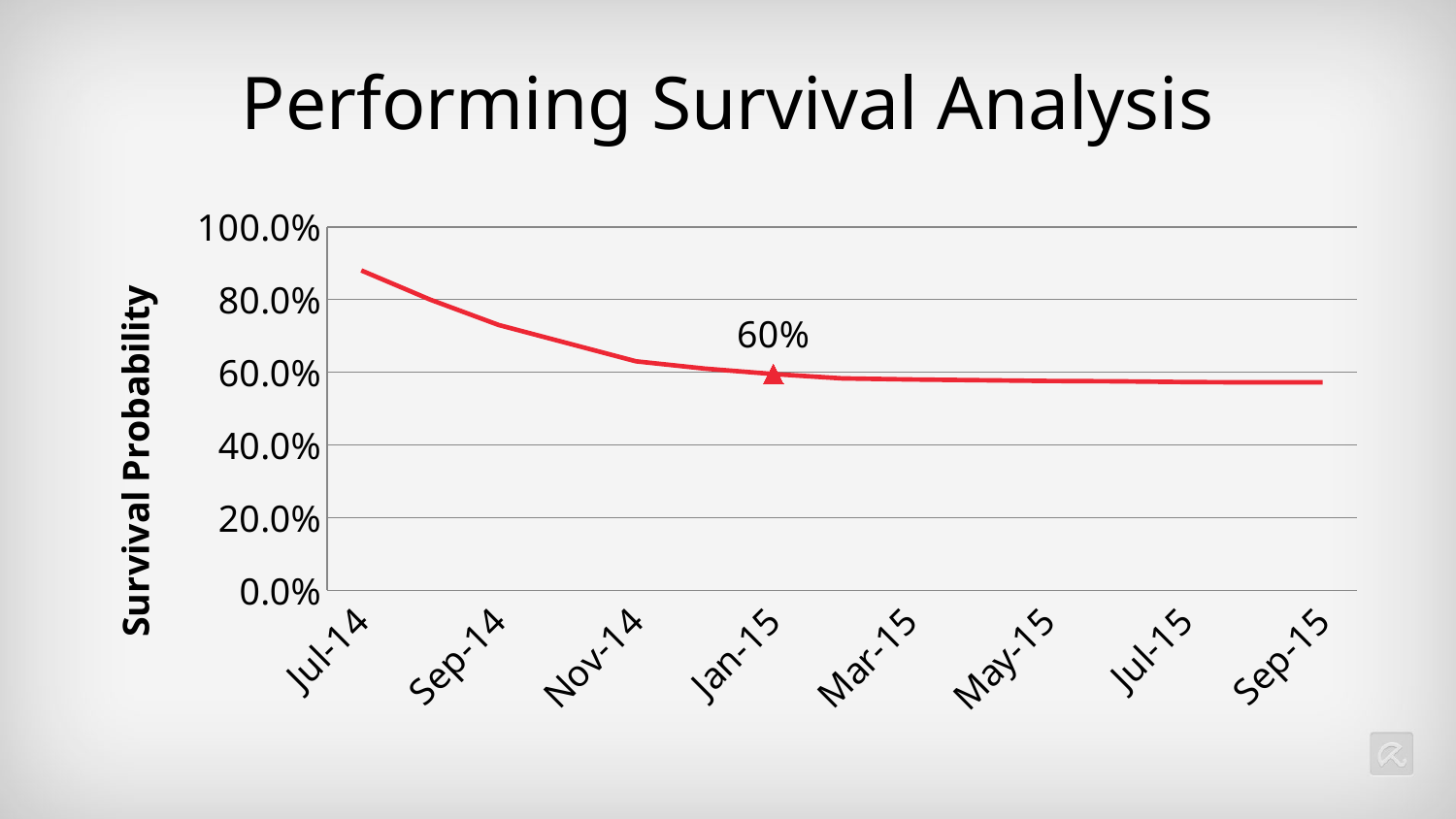
Does the survival probability rise or fall from Jul-14 to Sep-15? fall Is the survival probability at Sep-15 greater or less than 60.0%? less What survival probability is labelled on the chart at Jan-15? 60% Is the survival probability at Sep-14 greater or less than 80.0%? less At which month label is the survival probability highest? Jul-14 Is the survival probability at Mar-15 greater or less than 80.0%? less What kind of chart is shown on the slide? line chart What is the title of the vertical axis? Survival Probability How many month labels are shown on the x axis? 8 Which is larger, the survival probability at Sep-14 or at May-15? Sep-14 Which is larger, the survival probability at Jul-14 or at Sep-15? Jul-14